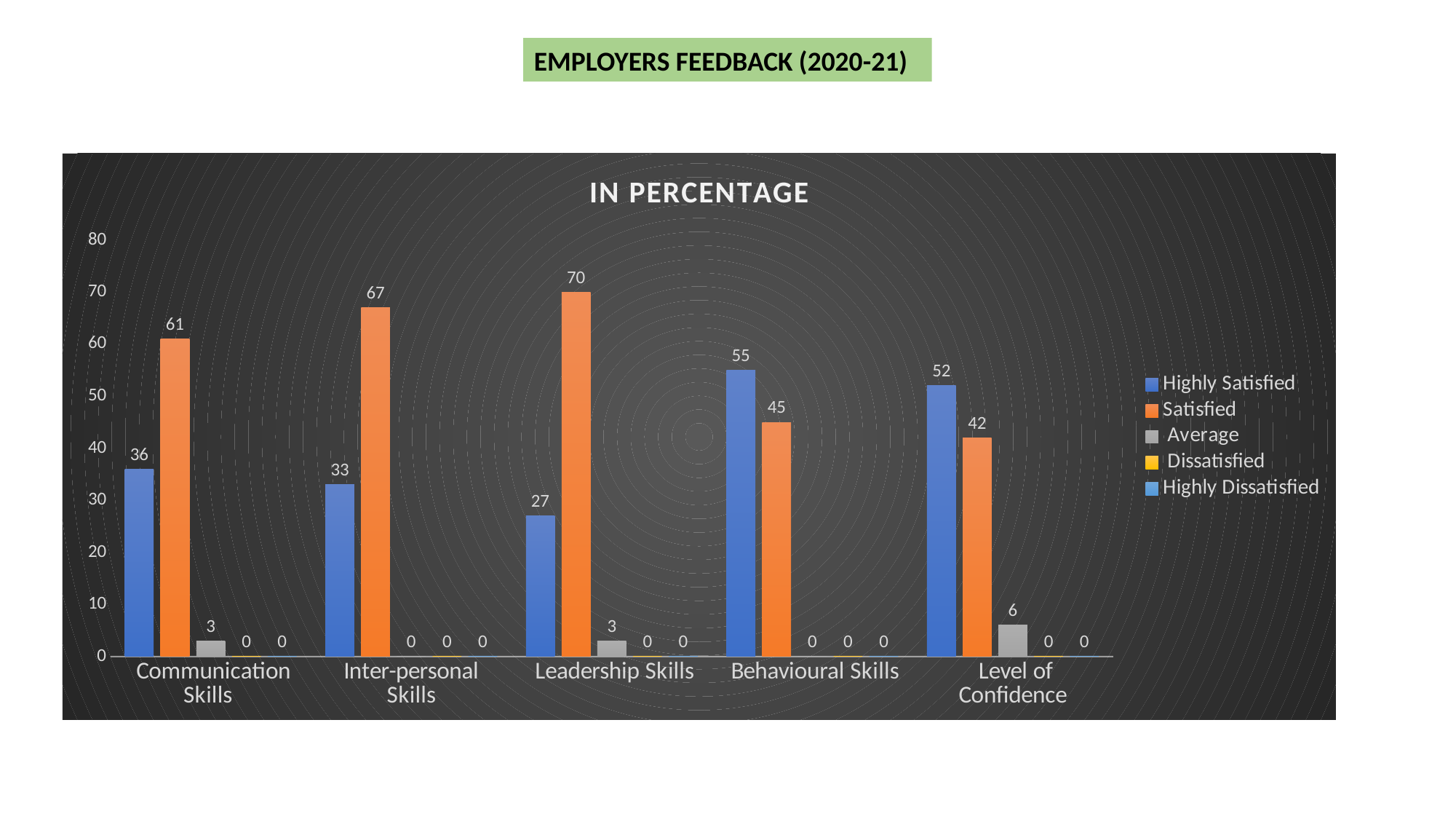
How many series does the legend list? 5 What kind of chart is shown? bar chart What is the Highly Satisfied value for Communication Skills? 36 Which category has the lowest Highly Satisfied value? Leadership Skills What is the Average value for Level of Confidence? 6 What is the difference between the Satisfied and Highly Satisfied values for Inter-personal Skills? 34 Which category has the highest Satisfied value? Leadership Skills What is the Satisfied value for Leadership Skills? 70 Is the Satisfied value for Communication Skills greater or less than 50? greater What is the title of the chart? IN PERCENTAGE How many categories are shown on the x axis? 5 Which is larger for Behavioural Skills: Highly Satisfied or Satisfied? Highly Satisfied